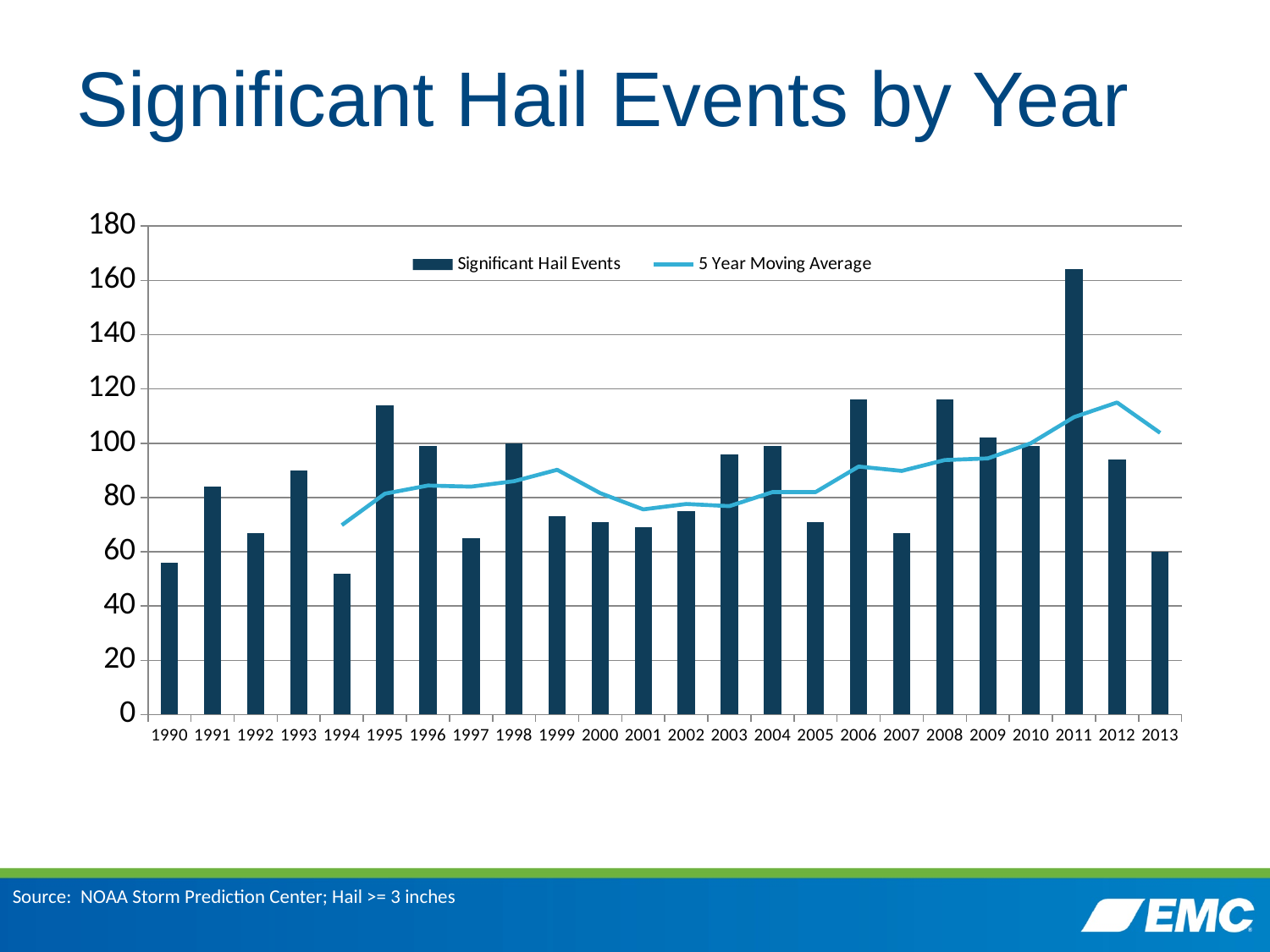
How many series does the legend list? 2 Is the value for Significant Hail Events in 1994 greater or less than 60? less Which year had more significant hail events, 2011 or 2012? 2011 What are the two entries in the chart legend? Significant Hail Events and 5 Year Moving Average Is the value for Significant Hail Events in 1997 greater or less than 80? less Which year has the highest number of significant hail events? 2011 How many years are shown on the x axis? 24 Is the value for Significant Hail Events in 2006 greater or less than 100? greater Which year had more significant hail events, 1993 or 1995? 1995 What kind of chart is shown on the slide? A bar chart with a line series Does the 5 Year Moving Average line rise or fall between 2005 and 2012? rise